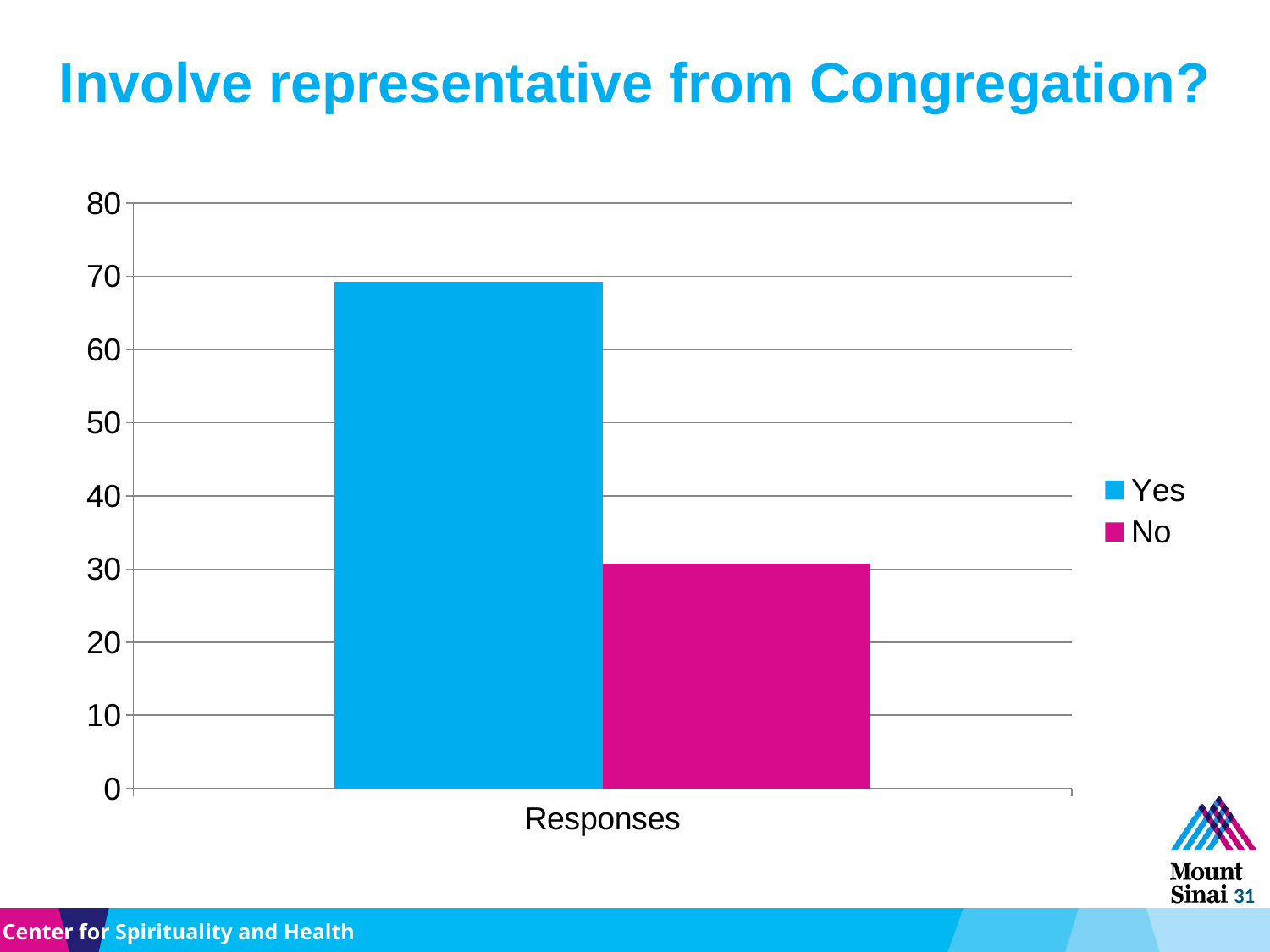
Which series has the lowest value? No Is the value for No greater or less than 20? greater Is the value for Yes greater or less than 60? greater Which is larger, the value for Yes or the value for No? Yes What is the label on the x axis? Responses How many categories are shown on the x axis? 1 How many series does the legend list? 2 What colour is the bar for the No series? magenta Which series has the highest value? Yes What kind of chart is shown on the slide? bar chart Is the value for Yes greater or less than 80? less